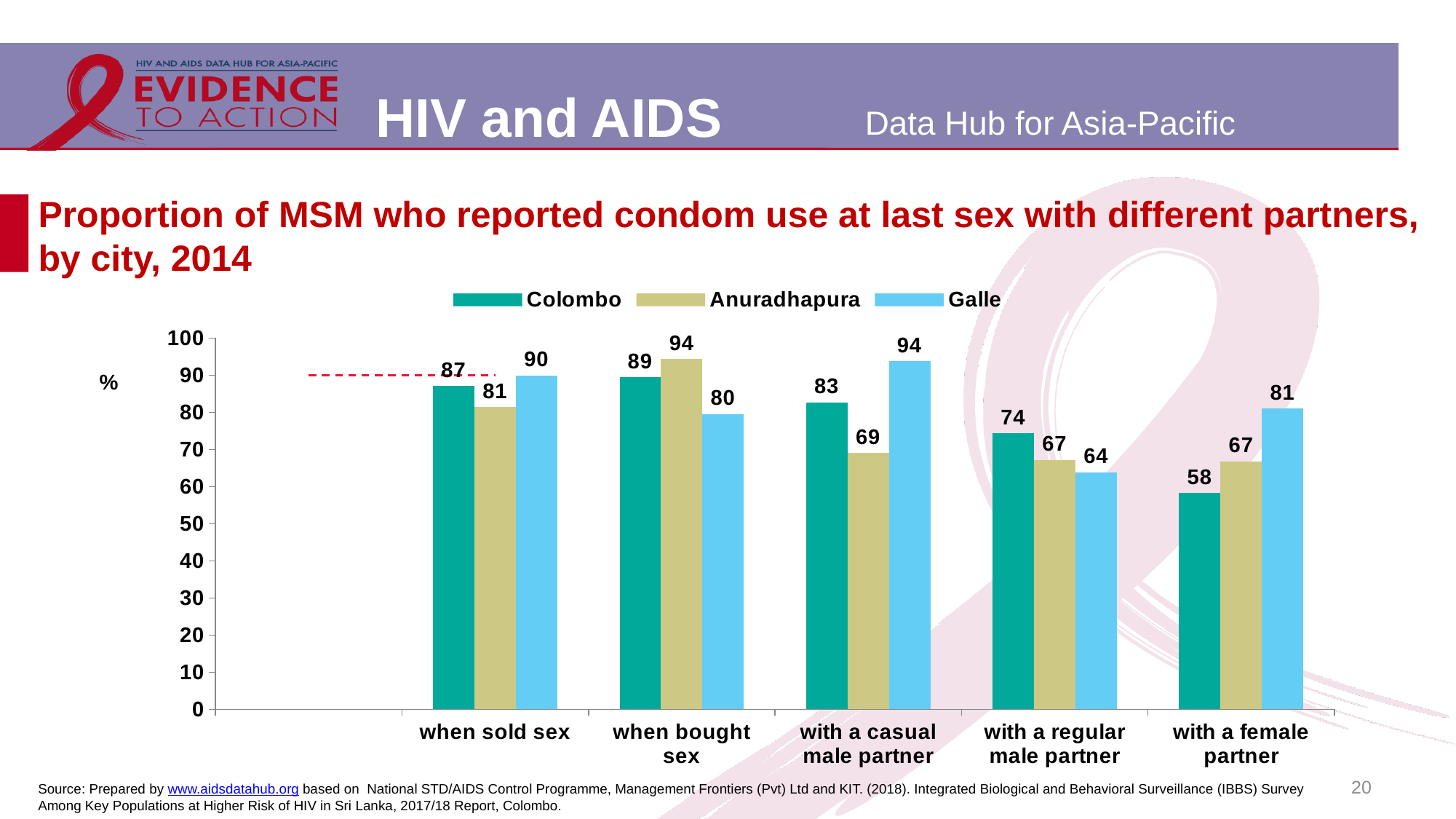
Is the value for Colombo with a female partner greater or less than 60? less What is the value for Galle when sold sex? 90 How many partner-type categories are shown on the x axis? 5 What kind of chart is shown on the slide? bar chart Which city has the lowest value with a regular male partner? Galle Which city has the highest value when bought sex? Anuradhapura What is the value for Colombo with a female partner? 58 What is the difference between the Galle and Anuradhapura values with a casual male partner? 25 Which city is represented by the light blue bars? Galle Which is larger: the Colombo value when sold sex or the Colombo value when bought sex? when bought sex How many series does the legend list? 3 What is the value for Anuradhapura with a casual male partner? 69